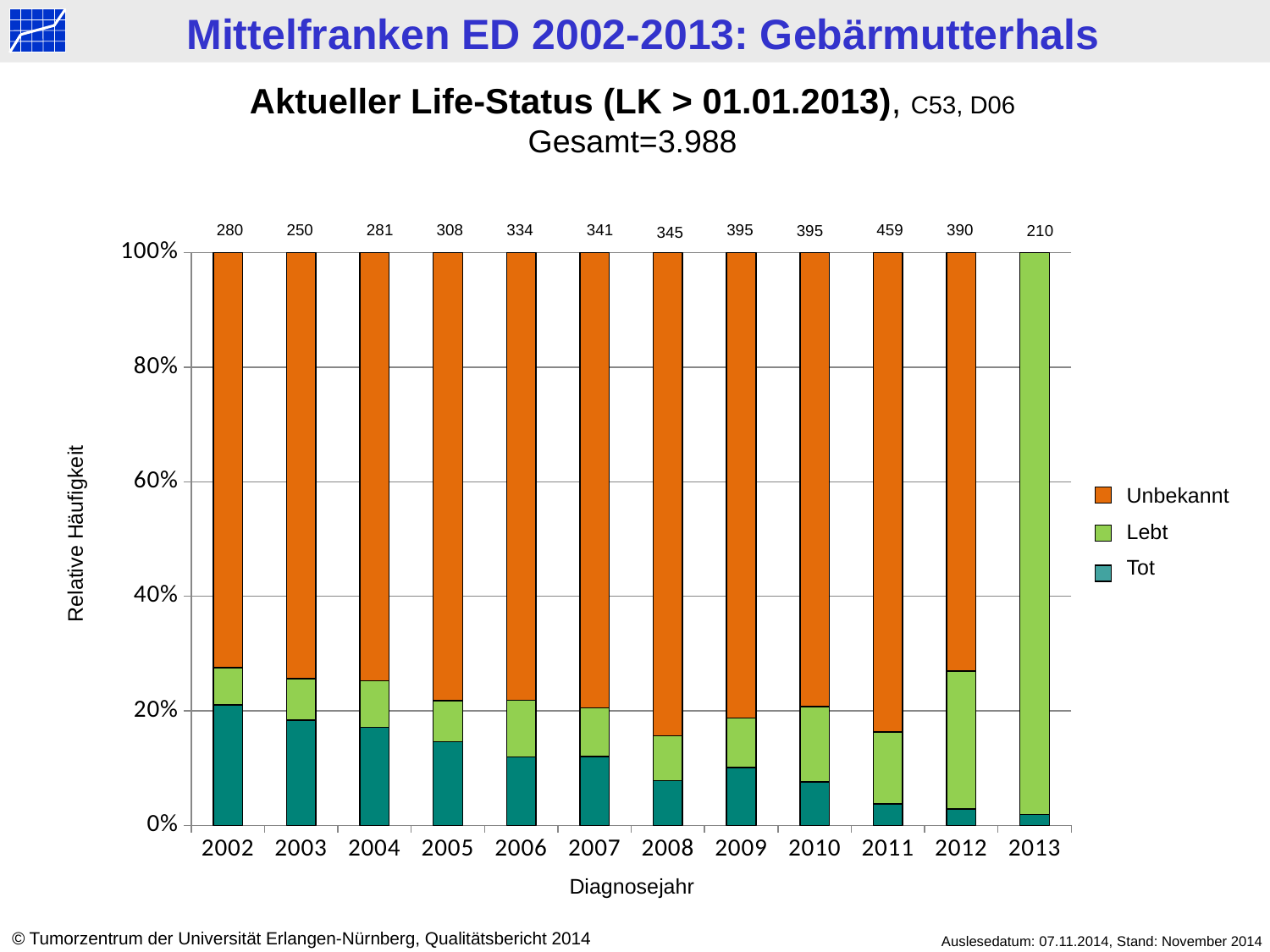
What is the number printed above the bar for 2011? 459 What is the number printed above the bar for 2002? 280 What is the number printed above the bar for 2013? 210 How many diagnosis years are shown on the x axis? 12 What is the difference between the numbers printed above the bars for 2011 and 2013? 249 Which diagnosis year has the lowest number printed above its bar? 2013 Is the Lebt share for 2013 greater or less than 80%? greater Is the Tot share for 2013 greater or less than 20%? less Which diagnosis year has the highest number printed above its bar? 2011 Which year has the larger number printed above its bar, 2009 or 2002? 2009 How many series does the legend list? 3 What kind of chart is shown on the slide? stacked bar chart